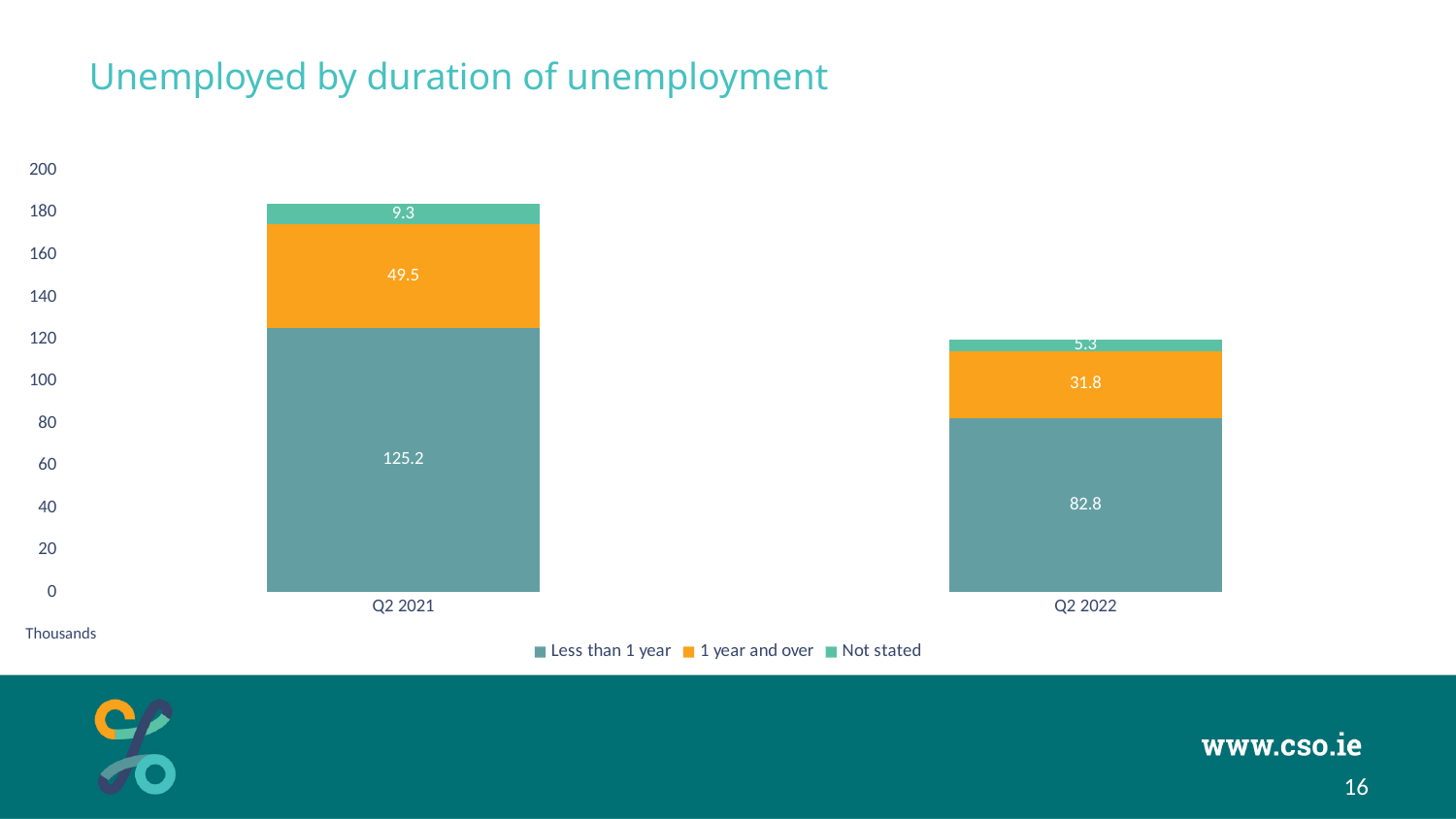
What kind of chart is shown on the slide? Stacked bar chart What is the value for 'Less than 1 year' in Q2 2022? 82.8 What is the value for '1 year and over' in Q2 2022? 31.8 How many categories are shown on the x axis? 2 What is the total of the stacked bar for Q2 2022? 119.9 What is the value for 'Not stated' in Q2 2021? 9.3 What is the value for 'Less than 1 year' in Q2 2021? 125.2 What is the total of the stacked bar for Q2 2021? 184.0 What is the difference between the 'Less than 1 year' values for Q2 2021 and Q2 2022? 42.4 How many series does the legend list? 3 What is the title of the chart? Unemployed by duration of unemployment Which quarter has the larger '1 year and over' value, Q2 2021 or Q2 2022? Q2 2021